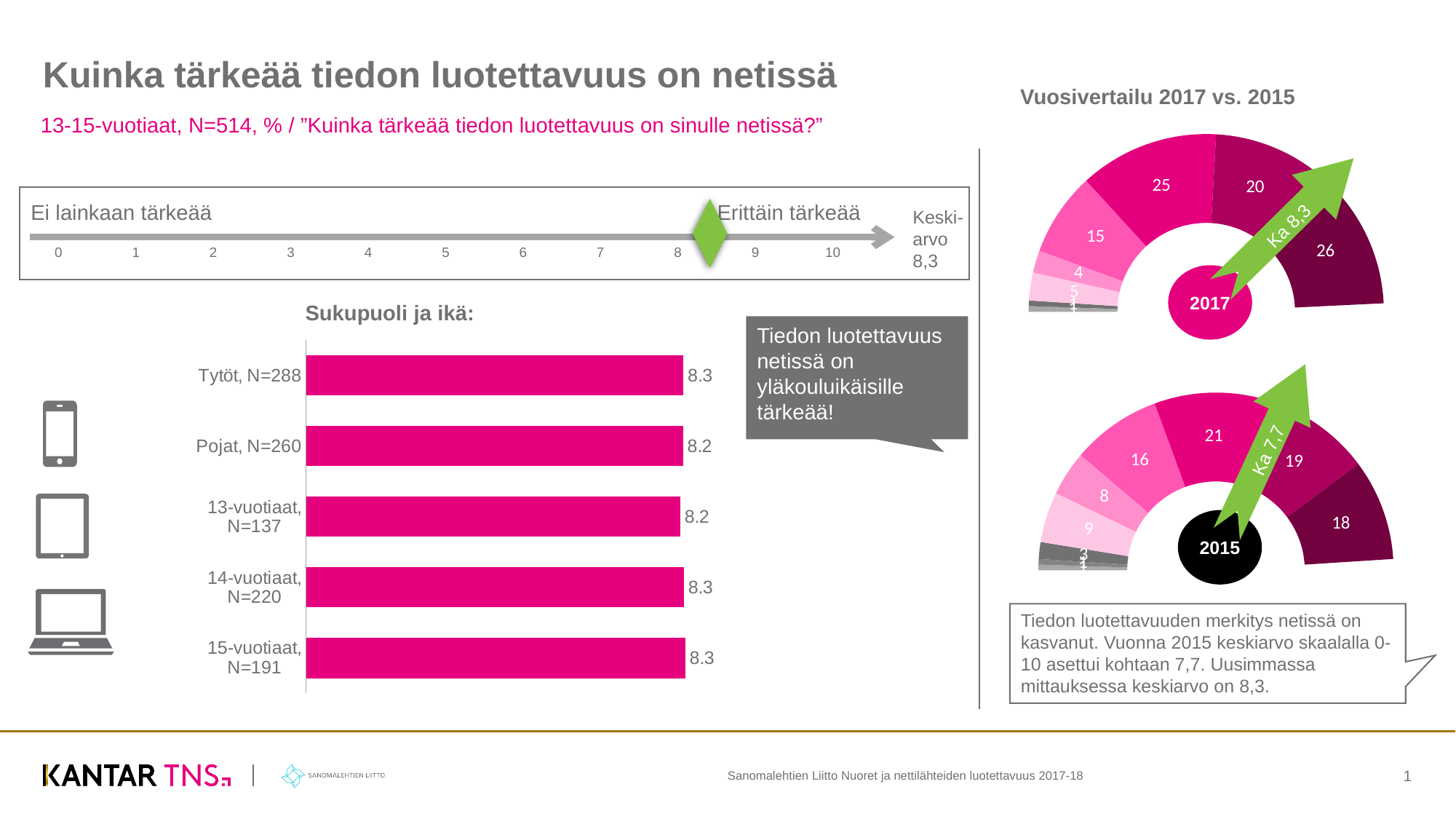
In the bar chart 'Sukupuoli ja ikä:', what is the value for 13-vuotiaat, N=137? 8.2 How many categories are shown in the bar chart 'Sukupuoli ja ikä:'? 5 What kind of chart is the 'Sukupuoli ja ikä:' chart? bar chart In the 2015 semicircle chart under 'Vuosivertailu 2017 vs. 2015', what is the value of the largest segment? 21 What average (Ka) is printed on the arrow of the 2015 semicircle chart? Ka 7,7 In the bar chart 'Sukupuoli ja ikä:', what is the difference between the values for Tytöt, N=288 and Pojat, N=260? 0.1 In the bar chart 'Sukupuoli ja ikä:', what is the value for 15-vuotiaat, N=191? 8.3 What is the title of the bar chart on the left side of the slide? Sukupuoli ja ikä: In the 2017 semicircle chart under 'Vuosivertailu 2017 vs. 2015', what is the value of the largest segment? 26 In the bar chart 'Sukupuoli ja ikä:', what is the value for Pojat, N=260? 8.2 In the bar chart 'Sukupuoli ja ikä:', what is the value for Tytöt, N=288? 8.3 In the bar chart 'Sukupuoli ja ikä:', which has the higher value: Tytöt, N=288 or Pojat, N=260? Tytöt, N=288